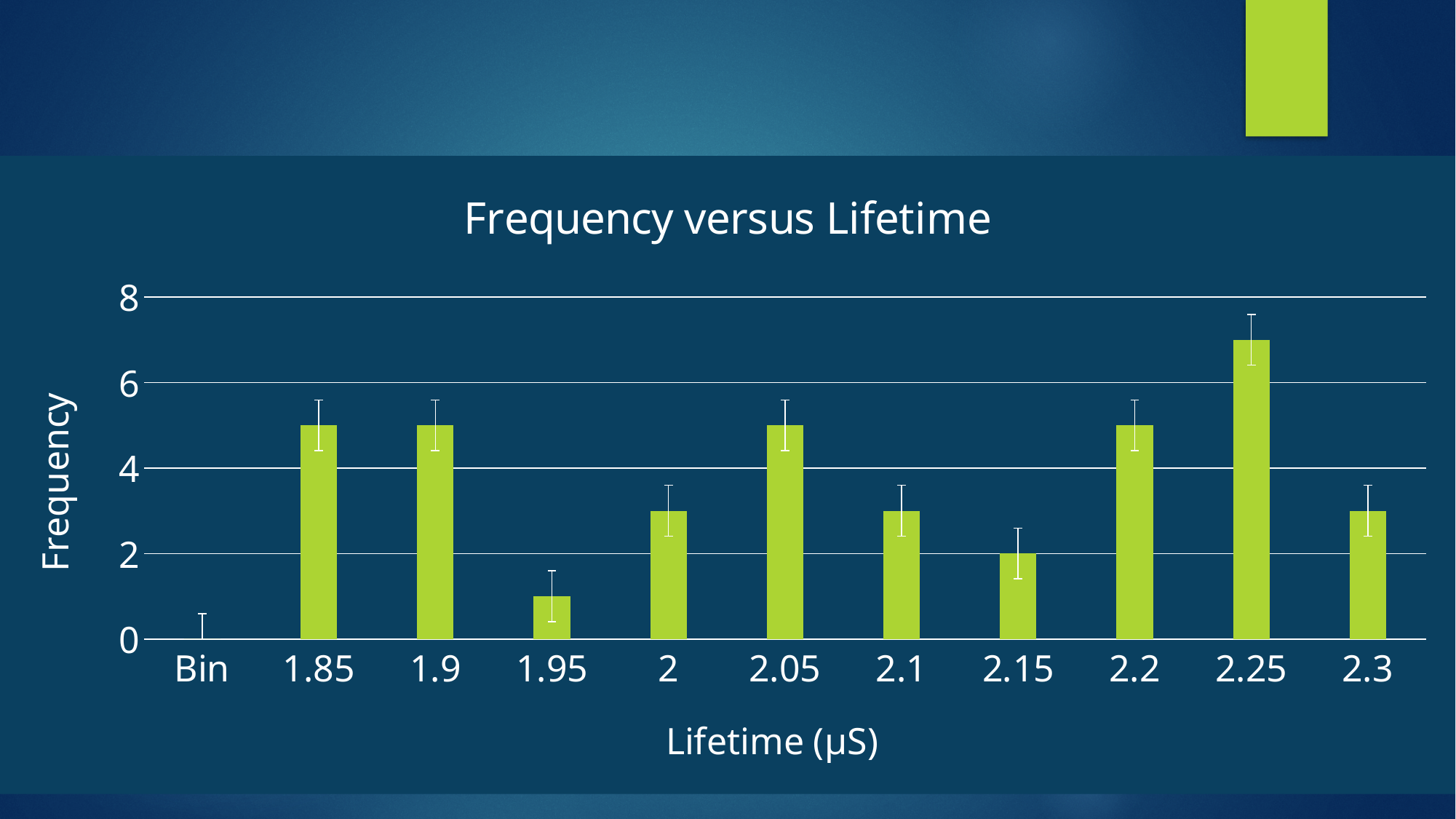
Is the frequency for 2.25 greater or less than 6? greater How many categories are shown on the x axis? 11 Which category has the highest frequency? 2.25 What kind of chart is shown on the slide? bar chart What is the title of the chart? Frequency versus Lifetime Is the frequency for 1.95 greater or less than 2? less What is the frequency for the 2.15 category? 2 Is the frequency for 1.85 greater or less than 4? greater What is the label of the x axis? Lifetime (µS) Which has the larger frequency, 1.95 or 2? 2 Which has the larger frequency, 2.2 or 2.25? 2.25